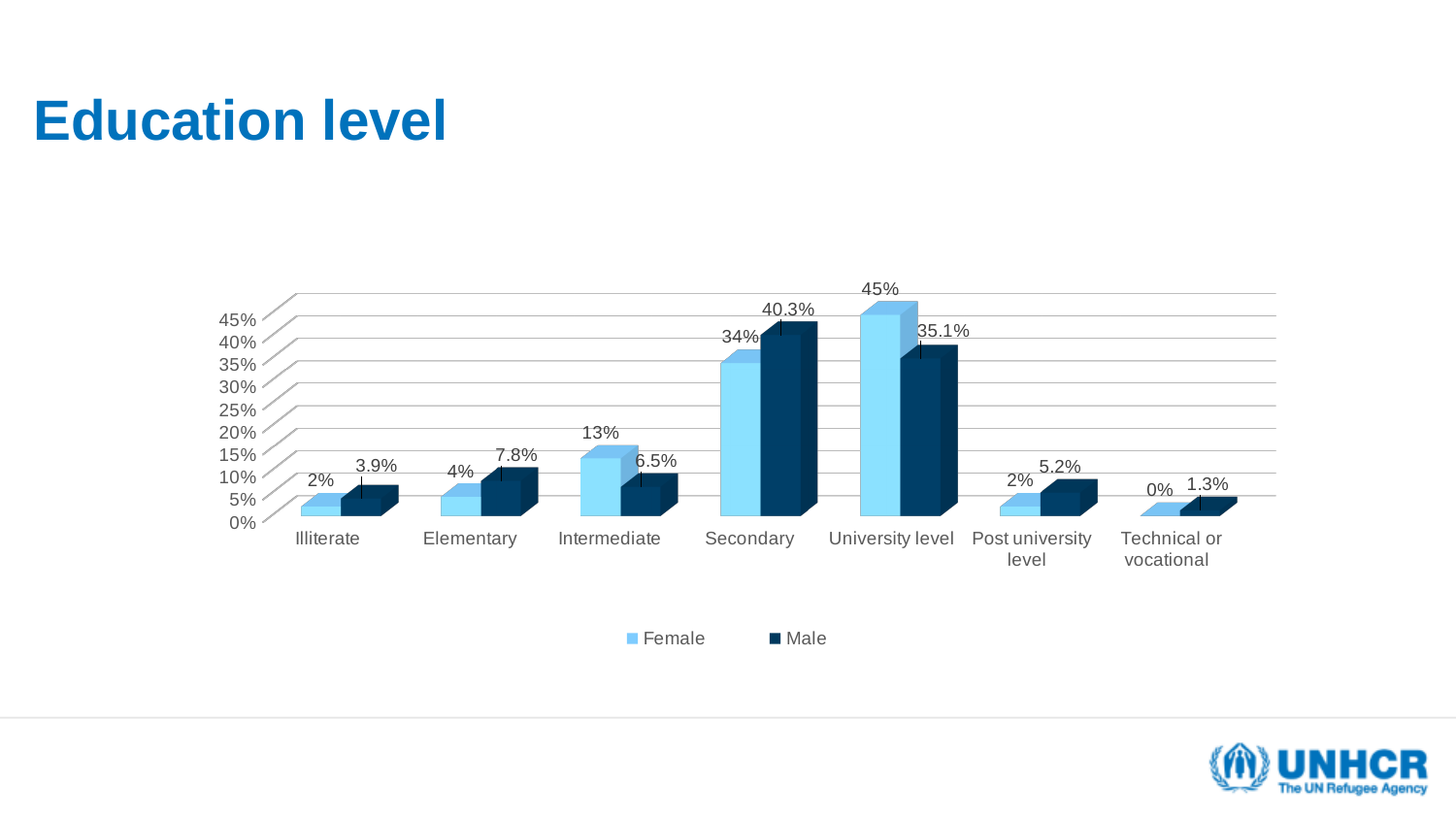
How many education level categories are shown on the x axis? 7 Which series is shown in the darker blue colour? Male For Intermediate, which is larger, the Female or the Male value? Female What is the Male value for Technical or vocational? 1.3% What is the difference between the Male and Female values for Elementary? 3.8% What kind of chart is shown on the slide? Bar chart What is the Male value for Secondary? 40.3% Which education level has the highest Male value? Secondary What is the Female value for Intermediate? 13% How many series does the legend list? 2 What is the Female value for University level? 45% Which education level has the lowest Female value? Technical or vocational